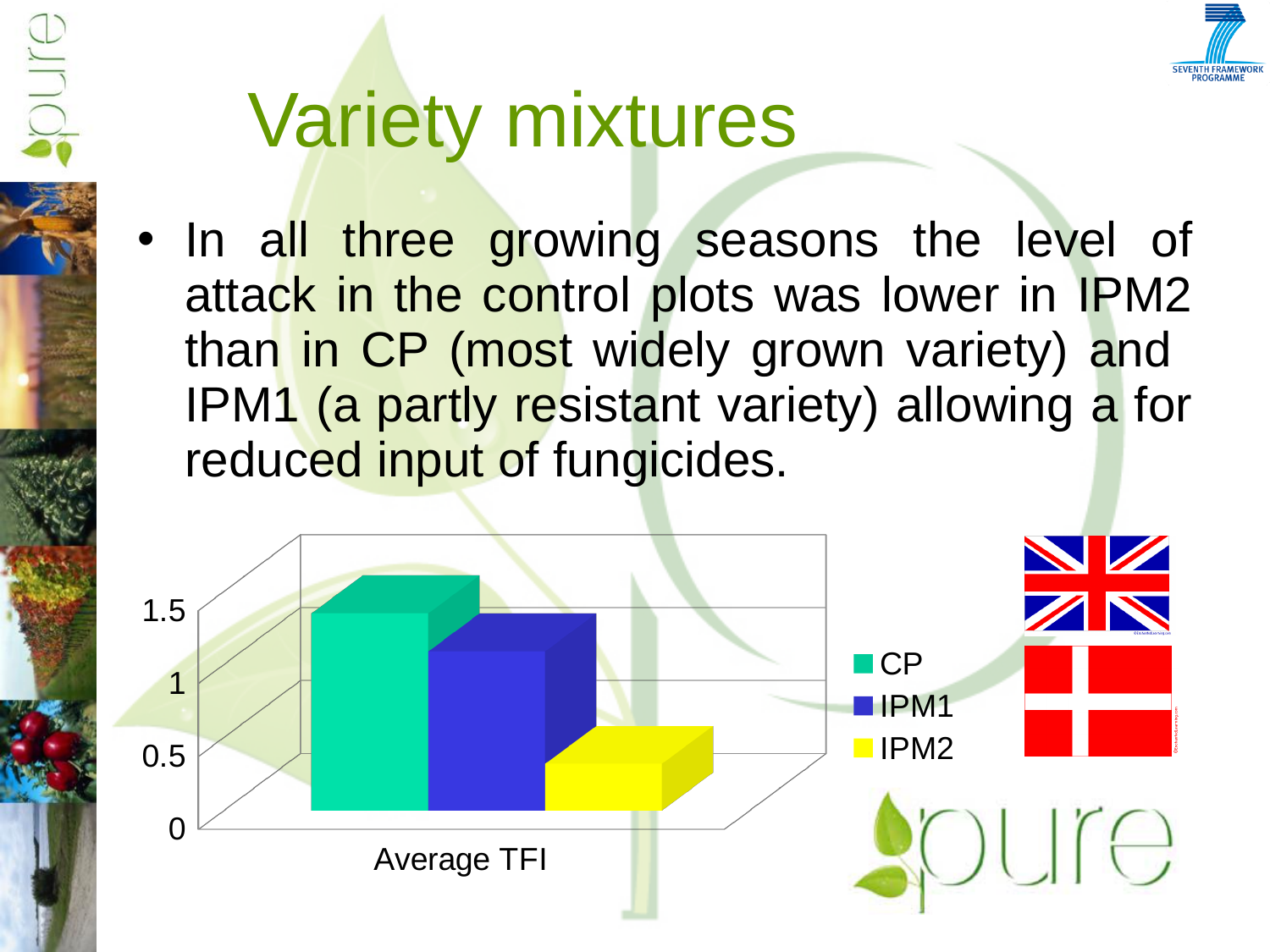
Which series has the highest Average TFI? CP What is the category label shown on the x axis of the chart? Average TFI How many categories are shown on the x axis of the chart? 1 Which has a higher Average TFI, IPM1 or IPM2? IPM1 Is the Average TFI for CP greater or less than 1? greater How many series does the chart legend list? 3 What kind of chart is shown on the slide? bar chart Is the Average TFI for IPM2 greater or less than 1? less Which has a higher Average TFI, CP or IPM1? CP What colour represents IPM2 in the chart legend? yellow Which series has the lowest Average TFI? IPM2